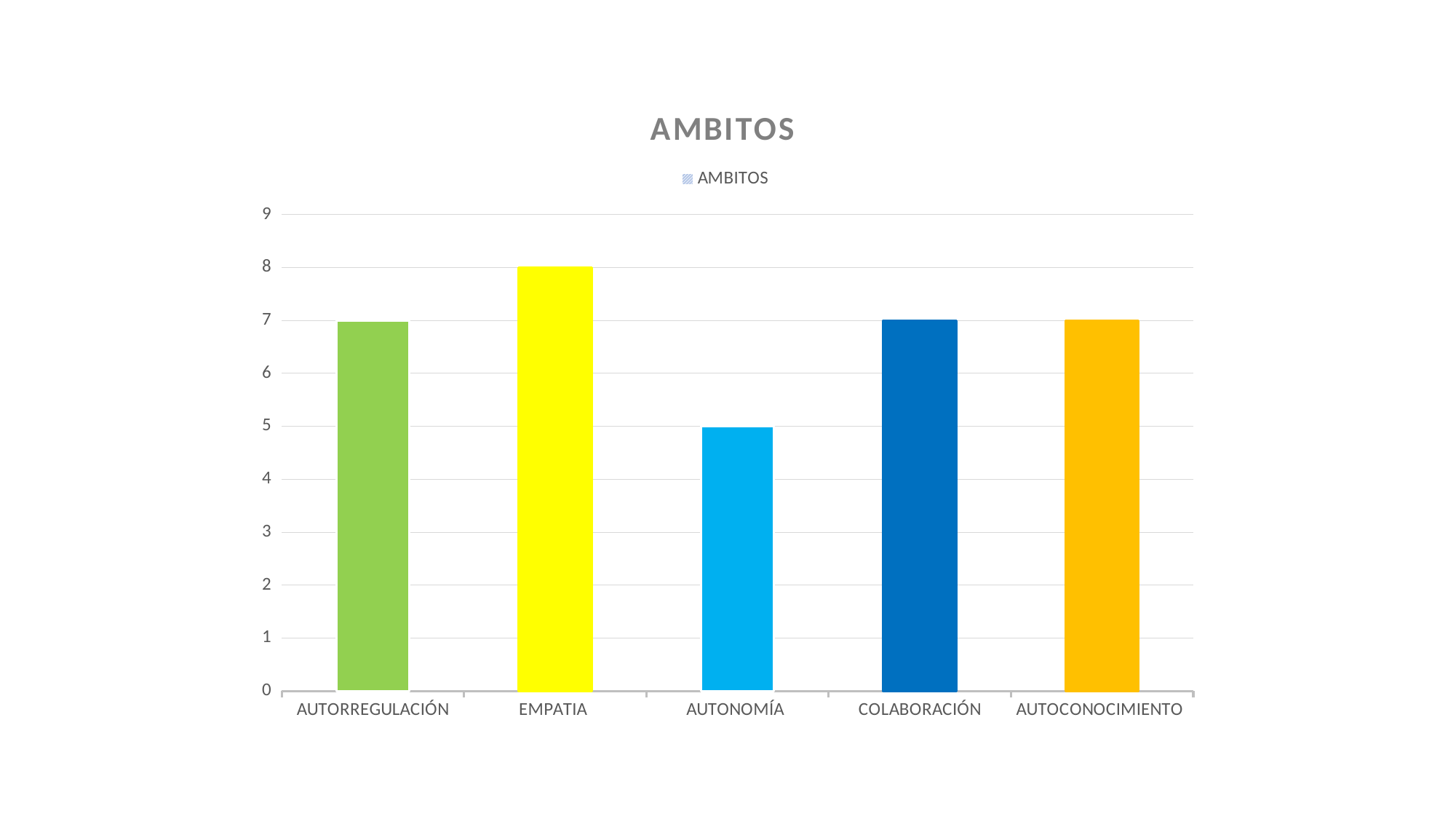
What is the difference between the values for EMPATIA and AUTONOMÍA? 3 What is the value for COLABORACIÓN? 7 What is the value for AUTONOMÍA? 5 How many categories are shown on the x axis? 5 What is the value for EMPATIA? 8 Which category has the lowest value? AUTONOMÍA What kind of chart is shown on the slide? bar chart Which category has the highest value? EMPATIA Which is larger, the value for EMPATIA or the value for AUTOCONOCIMIENTO? EMPATIA What is the value for AUTORREGULACIÓN? 7 How many series does the legend list? 1 Is the value for AUTONOMÍA greater or less than 6? less